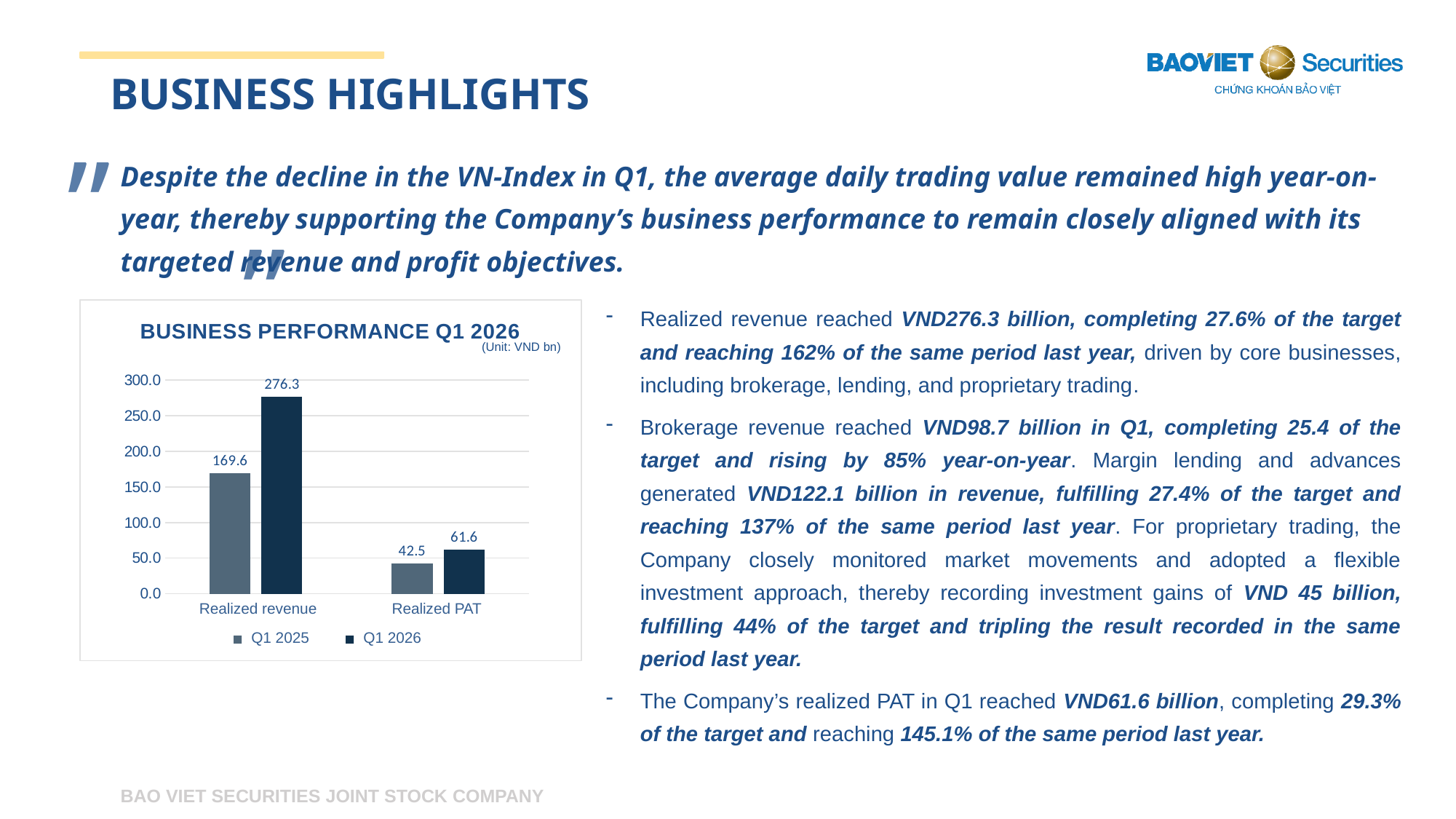
What kind of chart is shown on the slide? Bar chart Which is larger for Realized revenue, Q1 2025 or Q1 2026? Q1 2026 Which category has the highest Q1 2026 value? Realized revenue What is the Q1 2025 value for Realized PAT? 42.5 Which series has the lowest value for Realized PAT? Q1 2025 What is the difference between the Q1 2026 and Q1 2025 values for Realized revenue? 106.7 What is the Q1 2026 value for Realized PAT? 61.6 What is the difference between the Q1 2026 and Q1 2025 values for Realized PAT? 19.1 What is the Q1 2026 value for Realized revenue? 276.3 How many series does the legend list? 2 What is the Q1 2025 value for Realized revenue? 169.6 How many categories are shown on the x axis? 2